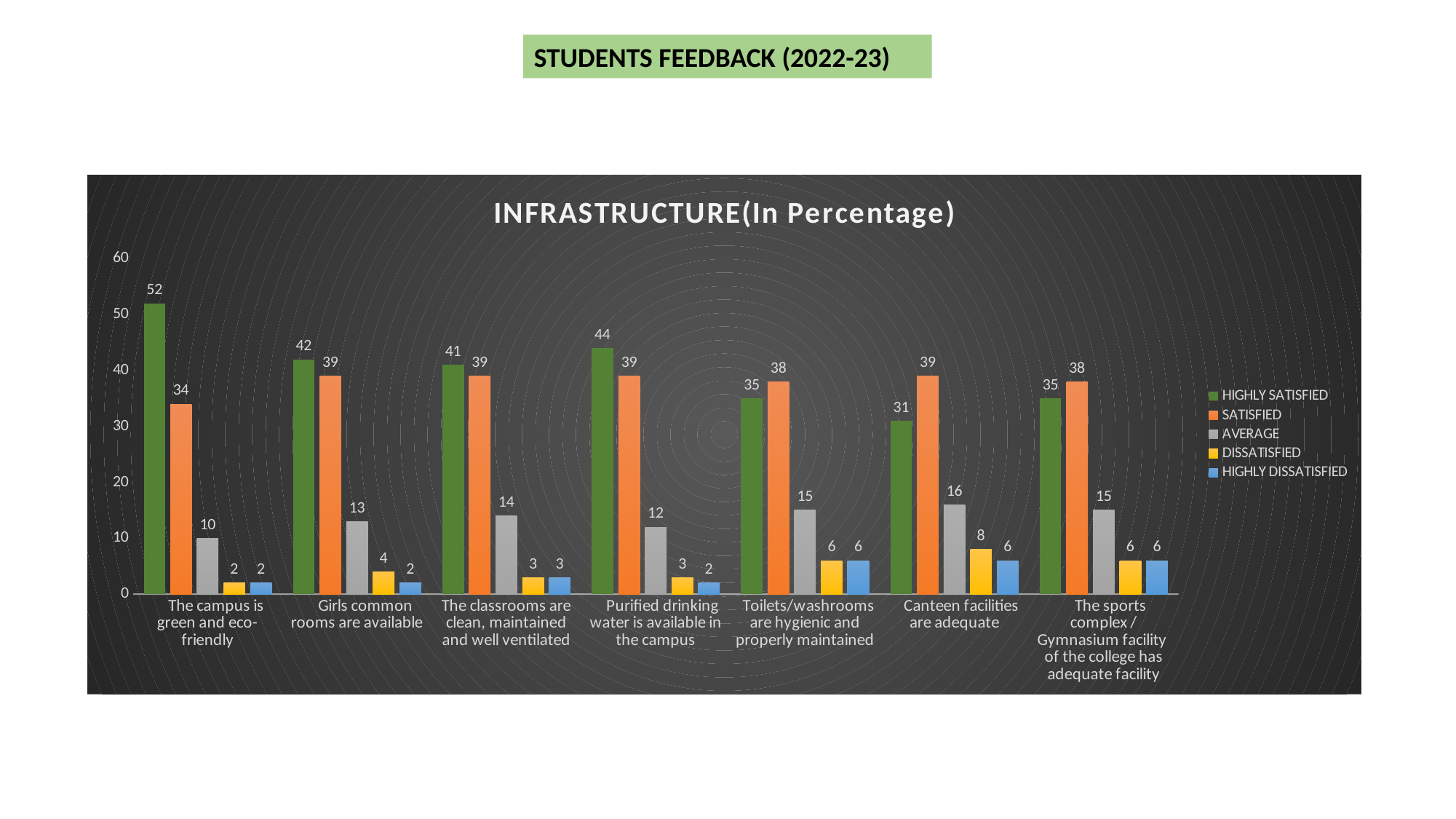
For 'Canteen facilities are adequate', which is larger: HIGHLY SATISFIED or SATISFIED? SATISFIED Which category has the lowest HIGHLY SATISFIED value? Canteen facilities are adequate Which category has the highest HIGHLY SATISFIED value? The campus is green and eco-friendly How many categories are shown on the x axis? 7 How many series does the legend list? 5 What kind of chart is shown on the slide? Bar chart Which colour represents the DISSATISFIED series? Yellow What is the title of the chart? INFRASTRUCTURE(In Percentage) What is the SATISFIED value for 'Toilets/washrooms are hygienic and properly maintained'? 38 What is the AVERAGE value for 'Canteen facilities are adequate'? 16 What is the difference between the HIGHLY SATISFIED and SATISFIED values for 'The campus is green and eco-friendly'? 18 What is the HIGHLY SATISFIED value for 'The campus is green and eco-friendly'? 52